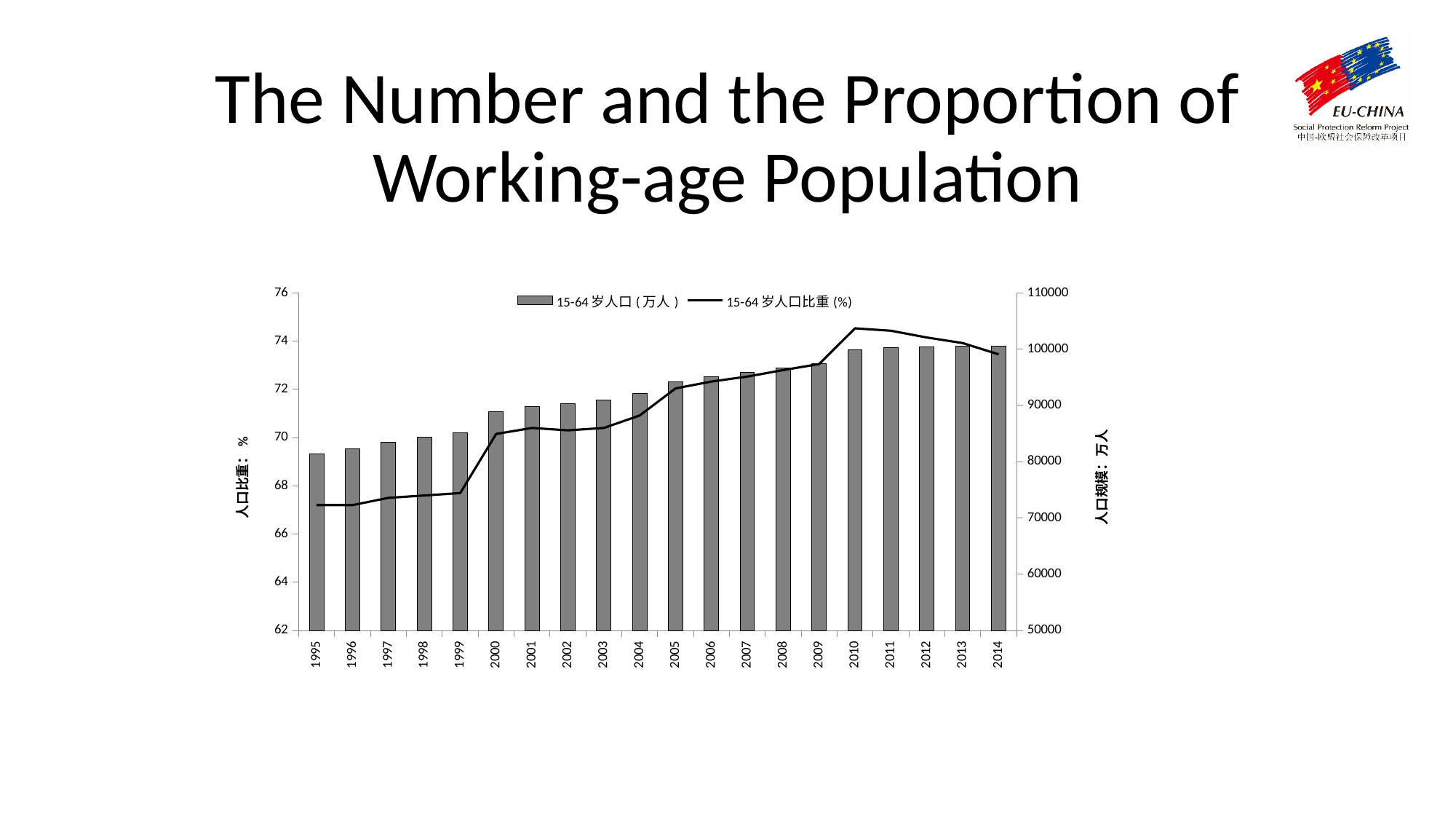
How many years are shown on the x axis of the chart? 20 Is the 15-64岁人口比重(%) line value for 1995 greater or less than 68? less In which year does the 15-64岁人口比重(%) line reach its highest point? 2010 What kind of chart is shown on the slide? A combined bar and line chart Do the bars for 15-64岁人口(万人) generally rise or fall from 1995 to 2014? rise How many series does the chart's legend list? 2 Is the 15-64岁人口比重(%) line value for 2010 greater or less than 74? greater Is the bar value for 2009 greater or less than 100000? less Which year has the shortest bar for 15-64岁人口(万人)? 1995